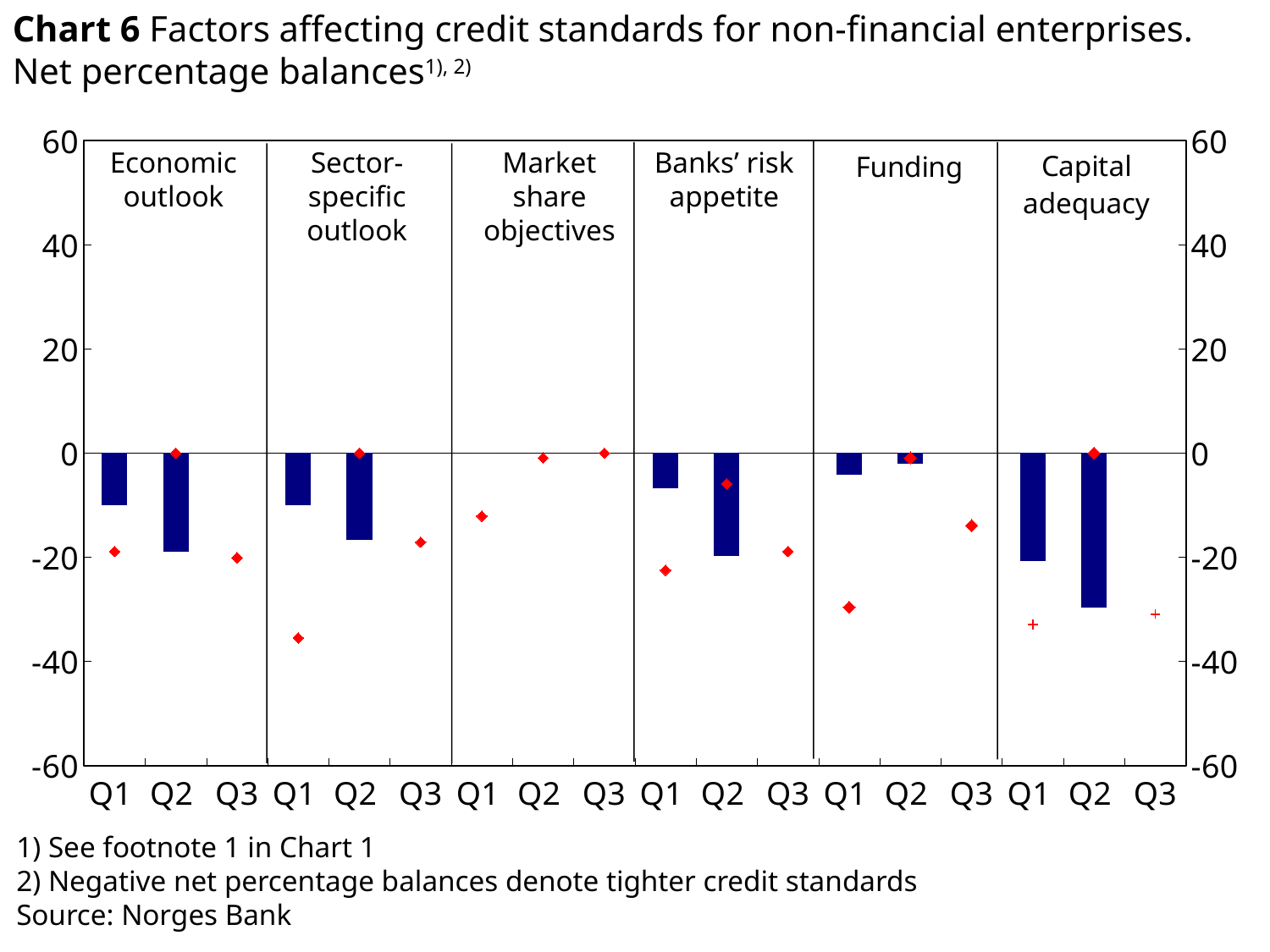
What is the source given for the chart? Norges Bank Is the Q1 marker for Sector-specific outlook greater or less than -20? less How many factors (panels) are shown along the x axis of the chart? 6 Which is lower, the Q2 bar for Capital adequacy or the Q2 bar for Funding? Capital adequacy For Banks' risk appetite, which bar is lower, Q1 or Q2? Q2 Is the Q1 marker for Funding greater or less than -20? less Is the Q2 bar for Capital adequacy greater or less than -20? less What kind of chart is shown on the slide? Bar chart How many quarters are shown within each factor panel? 3 Which factor has the lowest (most negative) Q2 bar? Capital adequacy